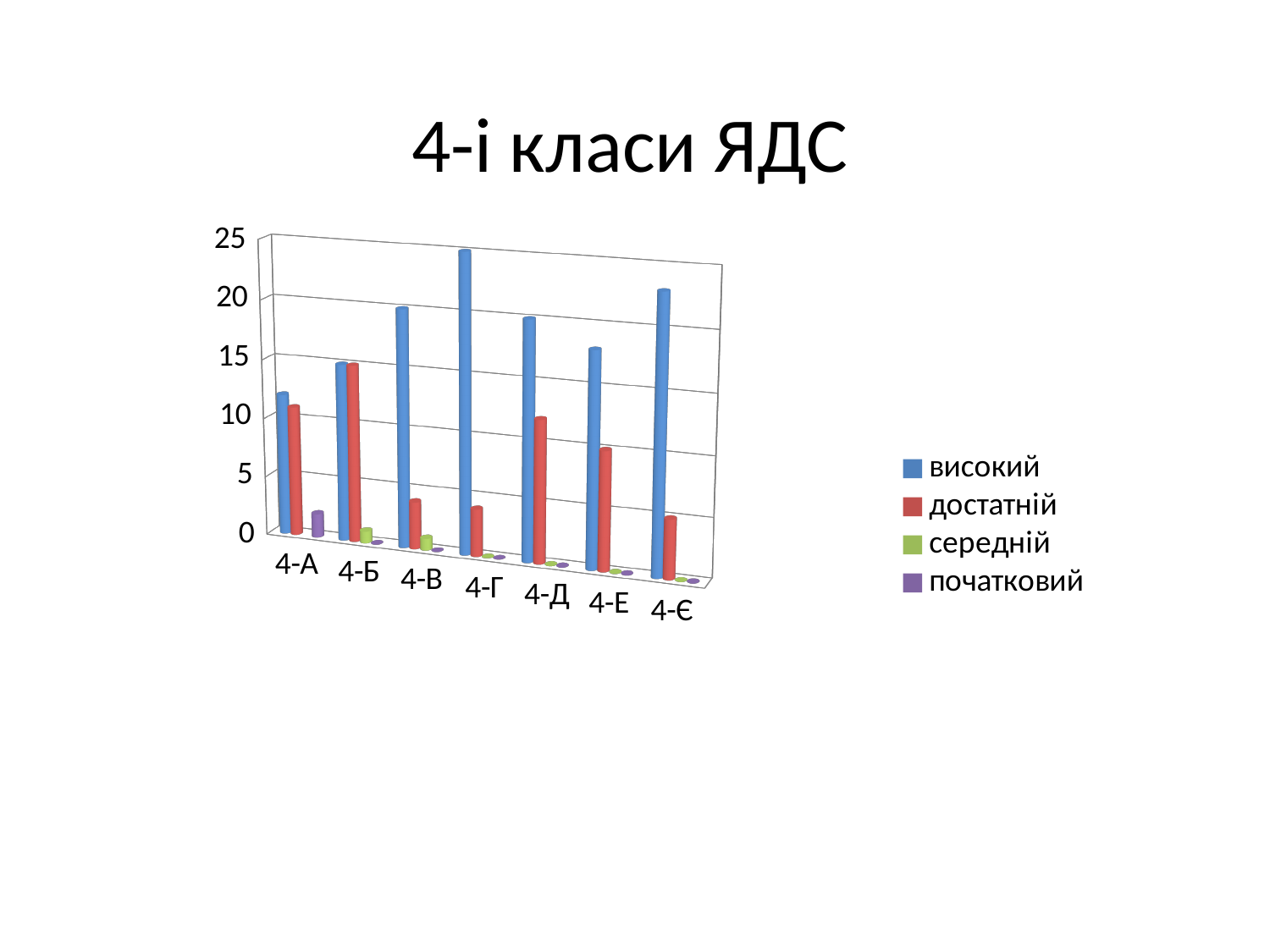
Which class has the highest value for the 'високий' series? 4-Г Is the 'достатній' value for 4-В greater or less than 5? less Is the 'високий' value for 4-Г greater or less than 20? greater Which is larger: the 'достатній' value for 4-Б or for 4-Г? 4-Б How many series does the legend list? 4 How many classes (categories) are shown on the x axis? 7 What is the title of the chart? 4-і класи ЯДС What kind of chart is shown on the slide? bar chart Is the 'високий' value for 4-Є greater or less than 15? greater Which class has the lowest value for the 'високий' series? 4-А For class 4-В, which is larger: the 'високий' value or the 'достатній' value? високий